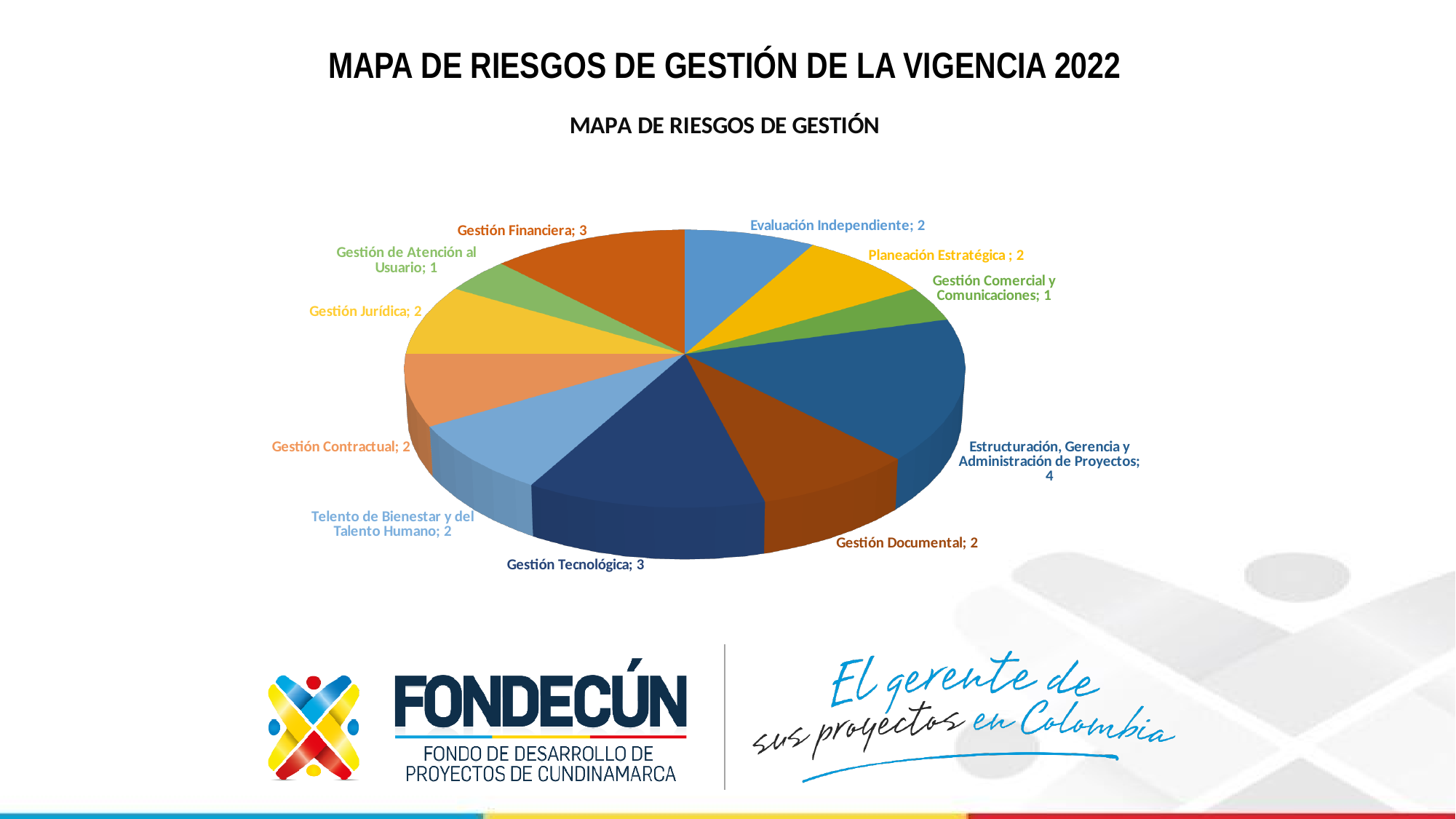
What share of the total does Gestión Tecnológica represent? 12.5% What is the title of the chart? MAPA DE RIESGOS DE GESTIÓN Which is larger, the value for Gestión Financiera or the value for Gestión Comercial y Comunicaciones? Gestión Financiera Which category has the highest value in the pie chart? Estructuración, Gerencia y Administración de Proyectos What is the value for Gestión Documental? 2 What is the difference between the values for Estructuración, Gerencia y Administración de Proyectos and Gestión Tecnológica? 1 What is the total of all the values shown in the pie chart? 24 What kind of chart is shown on the slide? Pie chart What is the value for Estructuración, Gerencia y Administración de Proyectos? 4 What is the value for Gestión de Atención al Usuario? 1 How many categories (slices) does the pie chart have? 11 What is the value for Gestión Financiera? 3